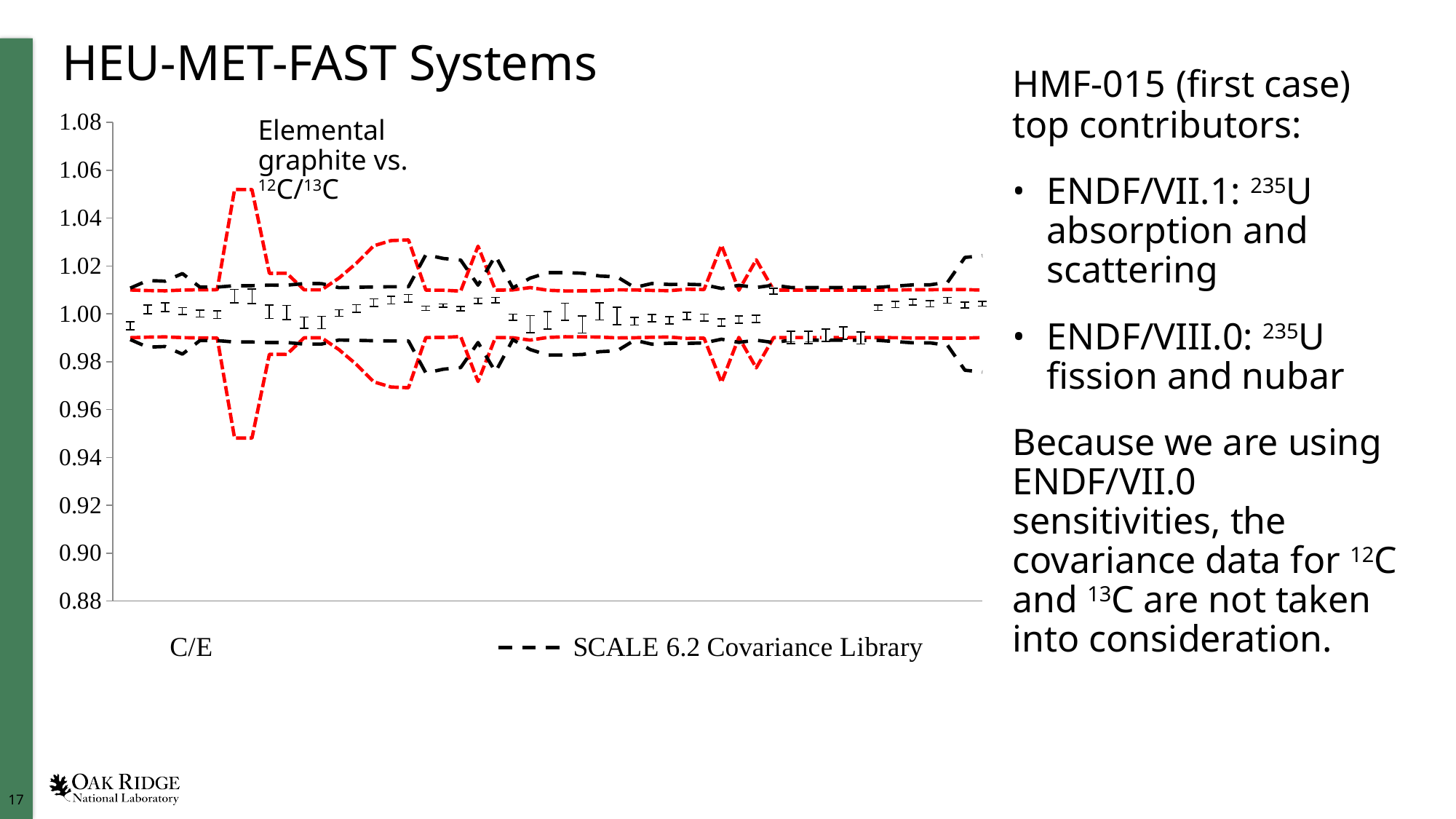
Is the lowest dip of the lower red dashed line greater or less than 0.96? less What is the highest value shown on the y axis of the chart? 1.08 Do all of the C/E error-bar points lie between 0.98 and 1.02 on the y axis? yes How many entries does the chart legend list? 2 What is the lowest value shown on the y axis of the chart? 0.88 Which legend entry is drawn as a black dashed line? SCALE 6.2 Covariance Library Is the highest peak of the upper red dashed line greater or less than 1.04? greater What kind of chart is shown on the slide? line chart